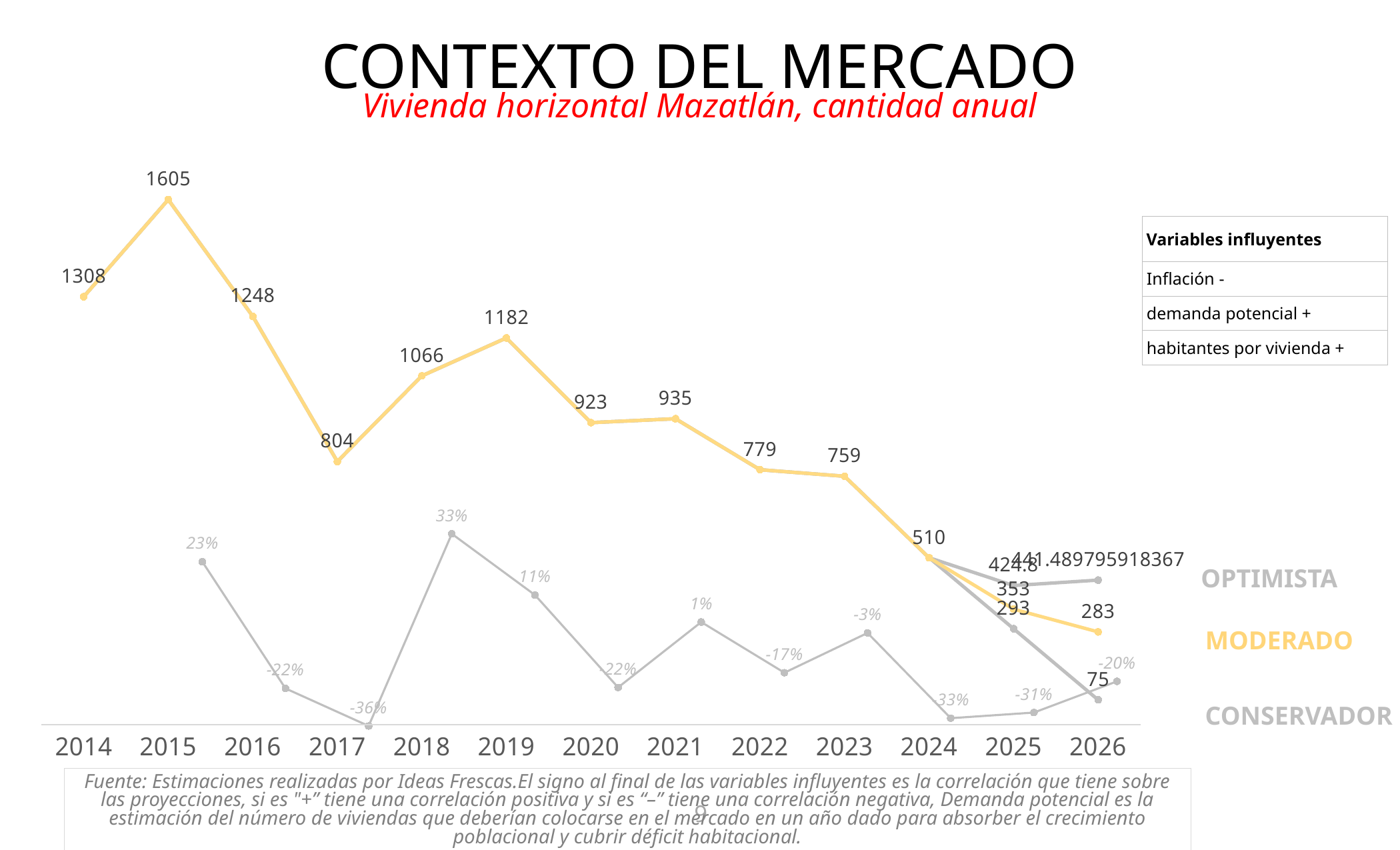
What is the OPTIMISTA value for 2025? 424.8 What is the lowest value shown on the yellow (MODERADO) line? 283 What is the difference between the 2015 value (1605) and the 2016 value (1248) on the yellow line? 357 What is the CONSERVADOR value for 2026? 75 What is the value of the yellow (MODERADO) line for 2026? 283 Which is larger on the yellow line: the value for 2018 or the value for 2019? 2019 How many years are shown on the x axis? 13 What kind of chart is shown on the slide? Line chart What is the value of the yellow (MODERADO) line for 2015? 1605 What is the percentage change label shown for 2018 on the grey line? 33% What is the value of the yellow (MODERADO) line for 2017? 804 In which year does the yellow (MODERADO) line reach its highest value? 2015